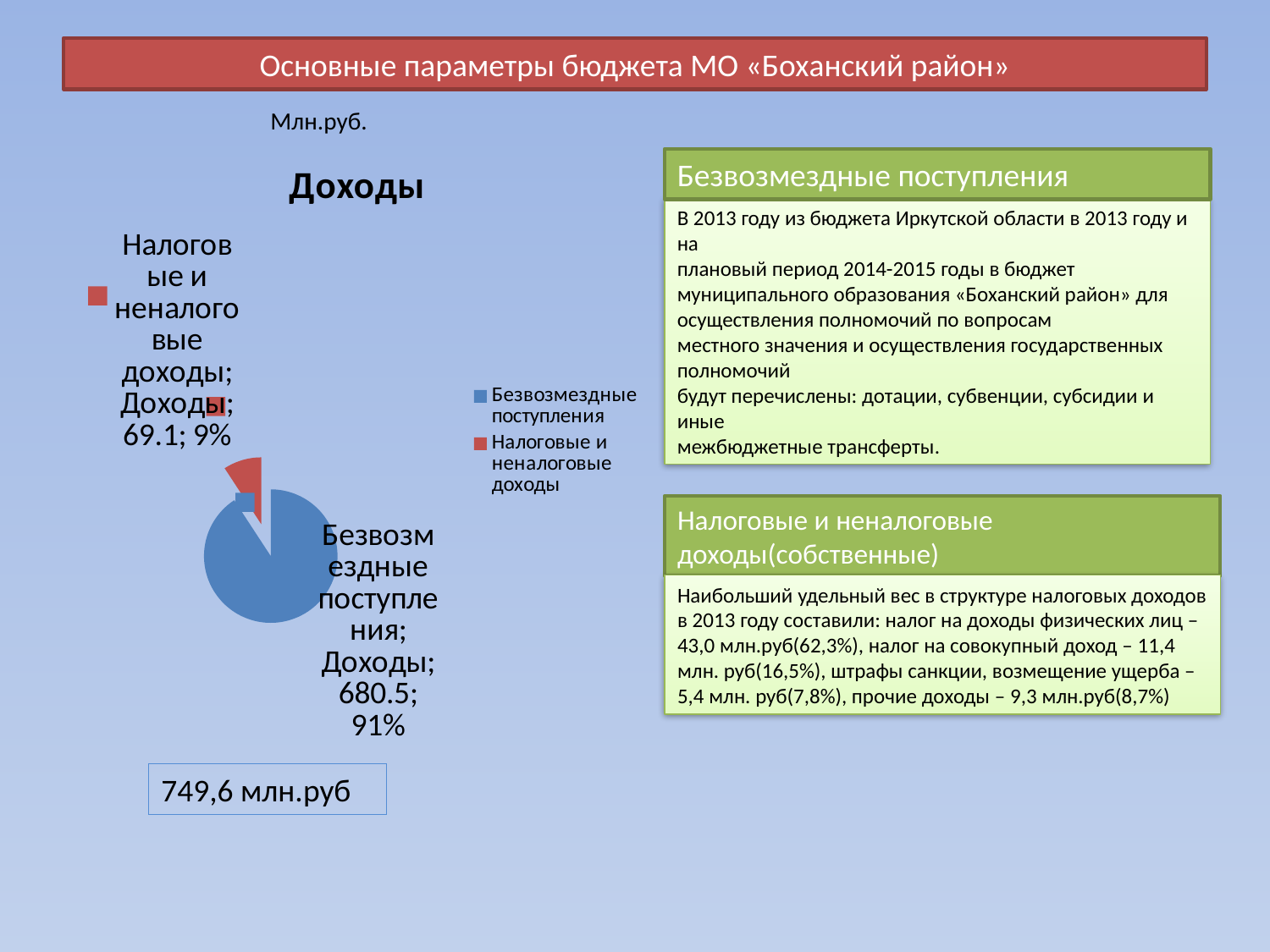
What type of chart is shown on the slide? pie chart Which slice of the pie chart is the smallest? Налоговые и неналоговые доходы What is the value for Налоговые и неналоговые доходы in the pie chart? 69.1 How many entries does the chart legend list? 2 What is the difference between the values for Безвозмездные поступления and Налоговые и неналоговые доходы? 611.4 What share of the pie does Налоговые и неналоговые доходы represent? 9% What is the value for Безвозмездные поступления in the pie chart? 680.5 What is the title of the chart? Доходы What share of the pie does Безвозмездные поступления represent? 91% Which slice of the pie chart is the largest? Безвозмездные поступления How many slices does the pie chart have? 2 Which is larger: Безвозмездные поступления or Налоговые и неналоговые доходы? Безвозмездные поступления